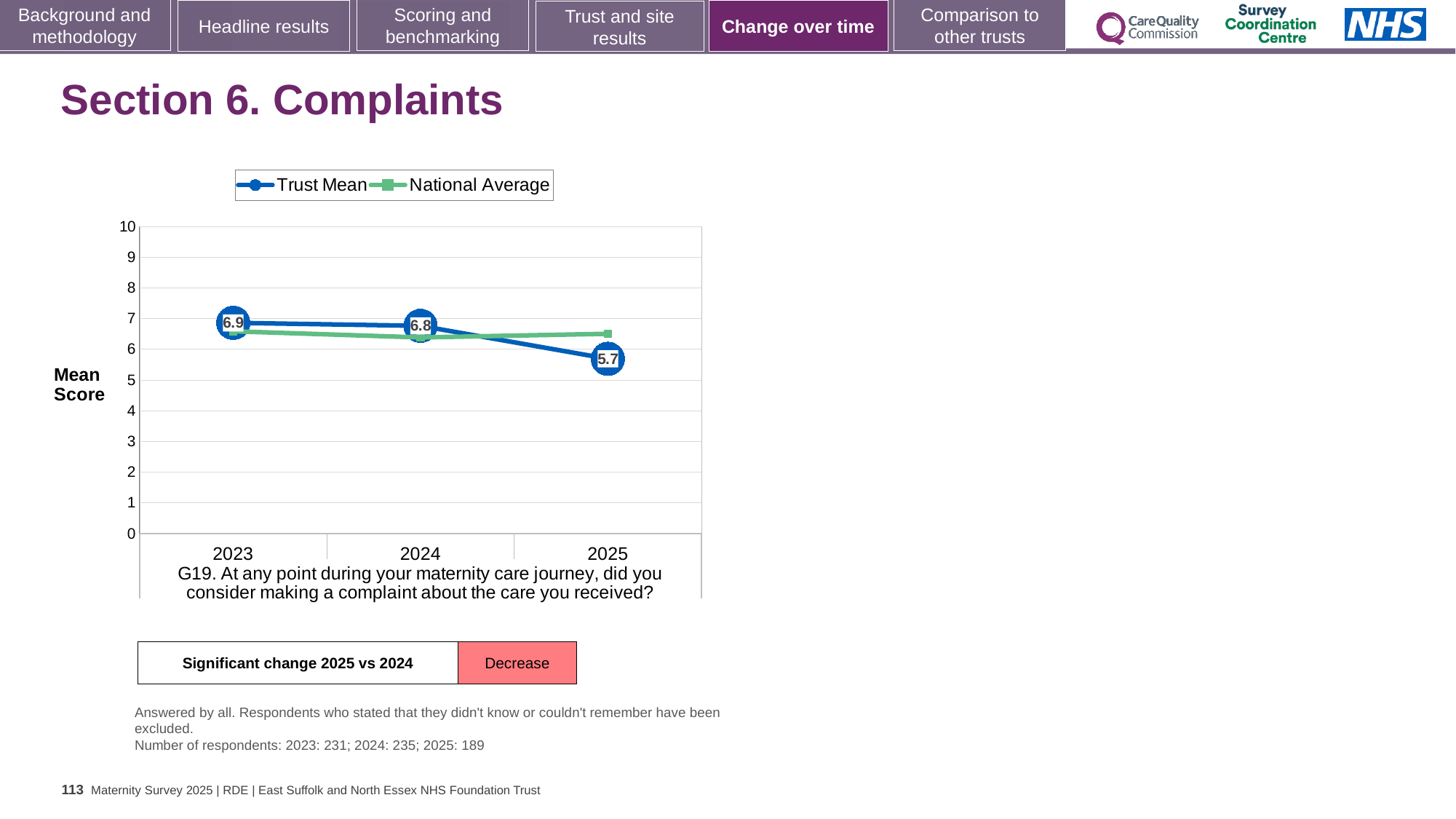
What is the difference between the Trust Mean in 2023 and in 2025? 1.2 What kind of chart is shown on the slide? Line chart What is the Trust Mean value for 2025? 5.7 Does the Trust Mean rise or fall from 2023 to 2025? Fall Which is larger in 2025, the Trust Mean or the National Average? National Average How many series does the legend list? 2 How many years are plotted on the x axis? 3 What is the Trust Mean value for 2023? 6.9 What is the Trust Mean value for 2024? 6.8 Is the National Average value for 2025 greater or less than 6? greater In which year is the Trust Mean lowest? 2025 In which year is the Trust Mean highest? 2023